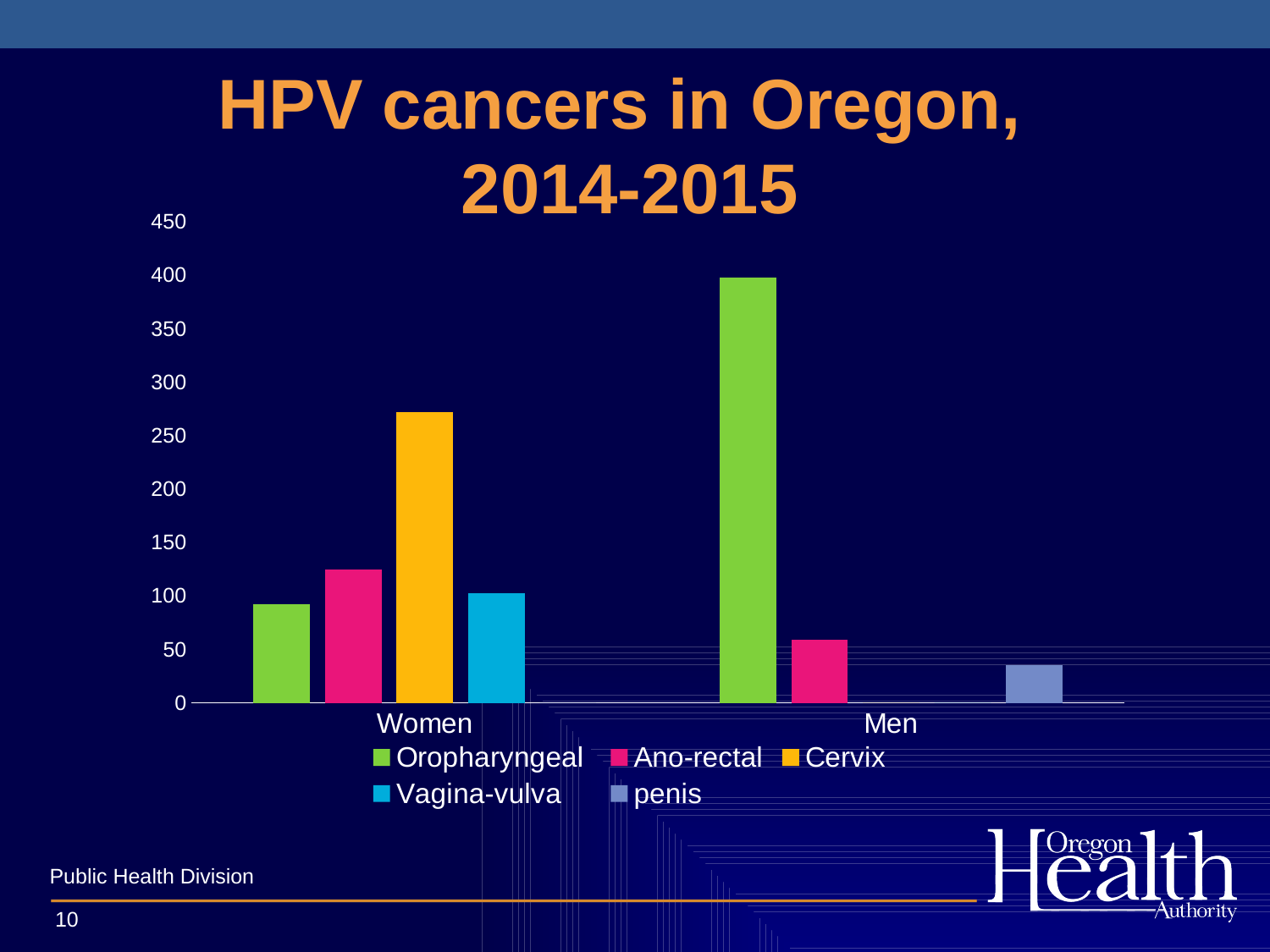
Is the Cervix value for Women greater or less than 250? greater What kind of chart is shown on the slide? Bar chart What is the title of the chart? HPV cancers in Oregon, 2014-2015 How many series does the legend list? 5 Which series has the tallest bar in the whole chart? Oropharyngeal (Men) Is the penis value for Men greater or less than 50? less How many categories are shown on the x axis? 2 Which series has the highest value for Women? Cervix Which is larger, the Oropharyngeal value for Women or for Men? Men Is the Oropharyngeal value for Men greater or less than 350? greater Which colour represents the Cervix series in the legend? Yellow/orange